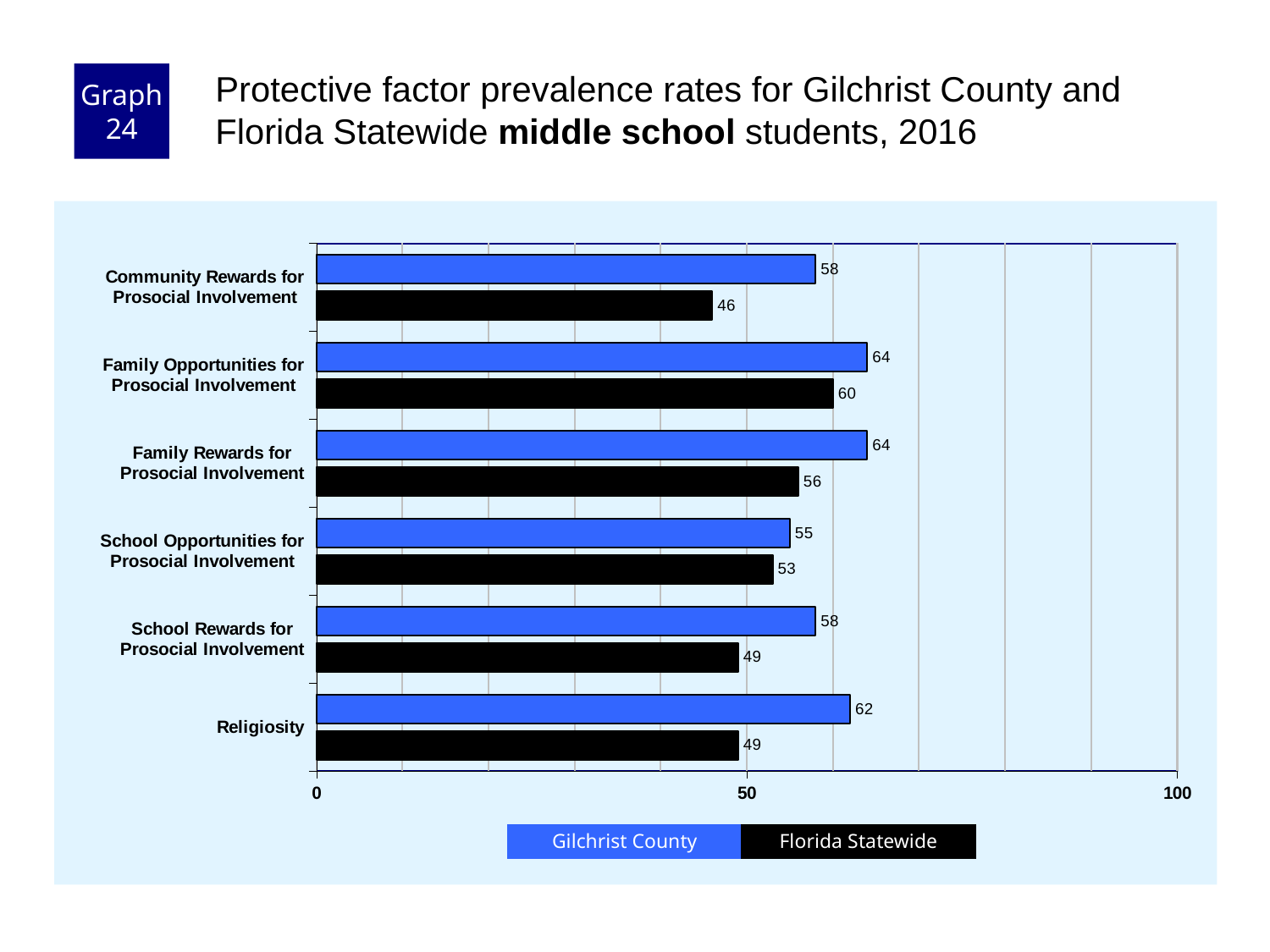
What is the difference between the Gilchrist County and Florida Statewide values for School Opportunities for Prosocial Involvement? 2 How many categories are shown on the chart? 6 What is the difference between the Gilchrist County and Florida Statewide values for Religiosity? 13 Which colour represents Florida Statewide in the chart? black What is the Gilchrist County value for Community Rewards for Prosocial Involvement? 58 What is the Florida Statewide value for Family Opportunities for Prosocial Involvement? 60 Which category has the lowest Gilchrist County value? School Opportunities for Prosocial Involvement What kind of chart is shown on the slide? bar chart Which category has the lowest Florida Statewide value? Community Rewards for Prosocial Involvement What is the Florida Statewide value for Religiosity? 49 Which is larger: the Gilchrist County value for Family Rewards for Prosocial Involvement or the Florida Statewide value for Family Rewards for Prosocial Involvement? Gilchrist County How many series does the legend list? 2